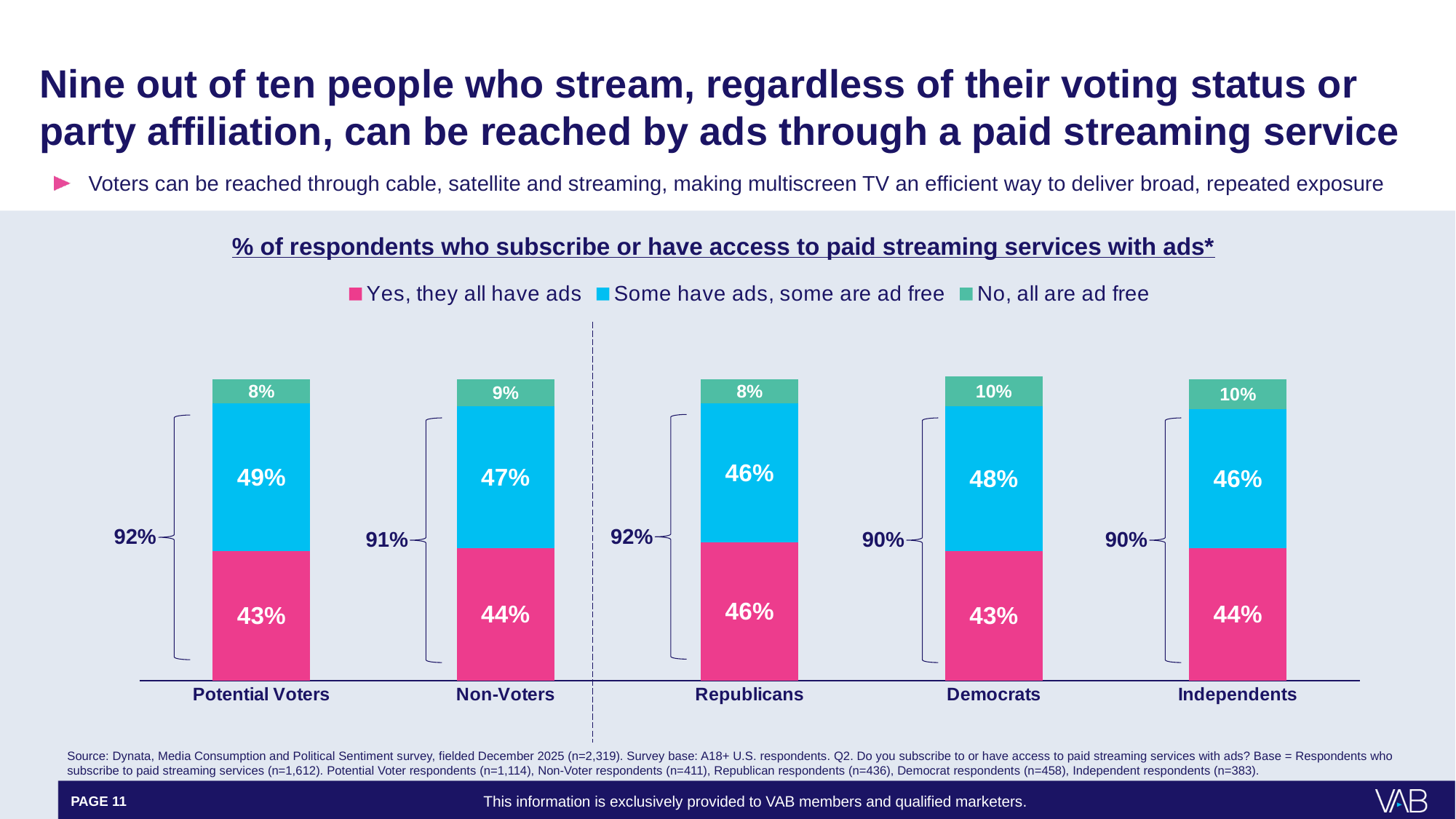
Which category has the highest share of respondents saying 'Some have ads, some are ad free'? Potential Voters Which category has the lowest share of respondents saying 'Yes, they all have ads'? Potential Voters and Democrats (43%) What percentage of Independents say all their streaming services are ad free? 10% What combined percentage of Non-Voters can be reached by ads (the bracketed total of the two ad segments)? 91% What percentage of Republicans say all their paid streaming services have ads? 46% What percentage of Potential Voters say all their paid streaming services have ads? 43% How many categories are shown on the x axis? 5 What percentage of Democrats say some of their streaming services have ads and some are ad free? 48% Which is larger: the 'Yes, they all have ads' value for Non-Voters or for Republicans? Republicans How many series does the legend list? 3 What kind of chart is shown on the slide? Stacked bar chart What is the difference between the 'Some have ads, some are ad free' values for Potential Voters and Republicans? 3 percentage points